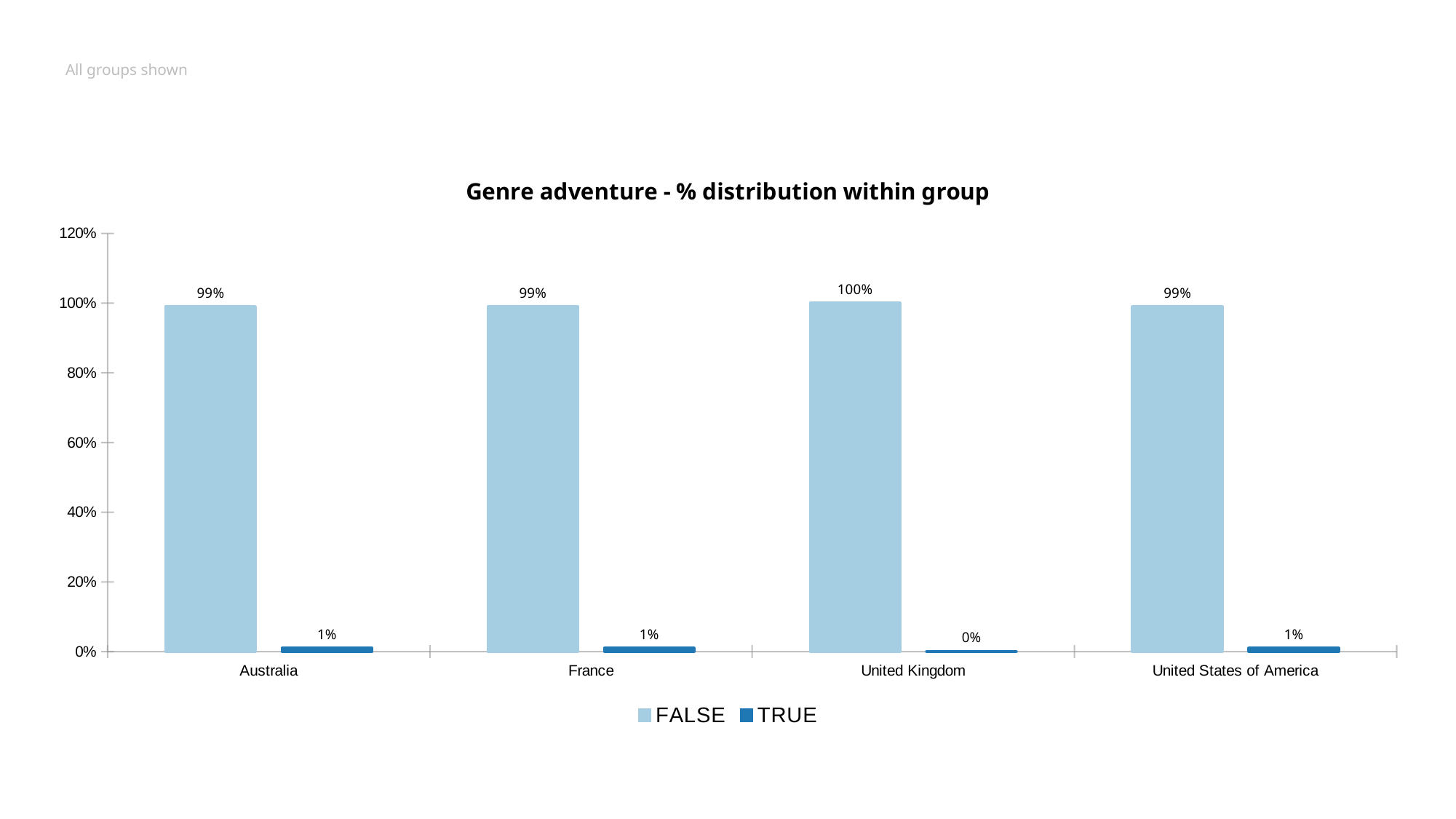
What is the TRUE value for United Kingdom? 0% What is the TRUE value for France? 1% How many countries are shown on the x axis? 4 What is the FALSE value for Australia? 99% How many series does the legend list? 2 What kind of chart is shown? bar chart Which is larger for France, the FALSE value or the TRUE value? FALSE What is the difference between the FALSE and TRUE values for Australia? 98% What is the FALSE value for United Kingdom? 100% Is the FALSE value for United States of America greater or less than 80%? greater Which country has the highest FALSE value? United Kingdom Which country has the lowest TRUE value? United Kingdom